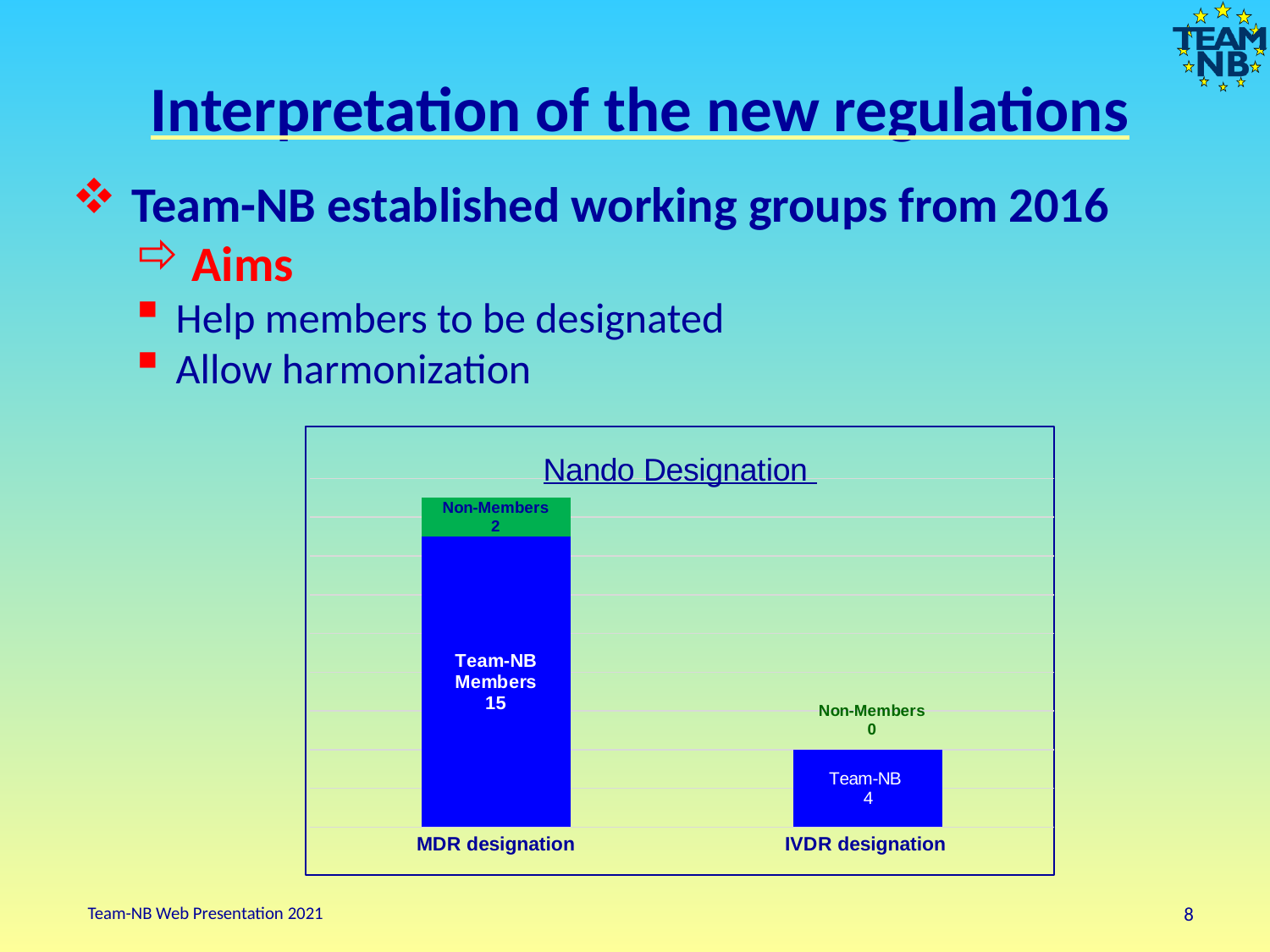
What type of chart is shown on the slide? stacked bar chart Which category has the lowest total? IVDR designation What is the title of the chart? Nando Designation How many categories are shown on the x axis? 2 How many Team-NB members are shown for IVDR designation? 4 How many Non-Members are shown for IVDR designation? 0 Which category has the higher total, MDR designation or IVDR designation? MDR designation How many Team-NB Members are shown for MDR designation? 15 What is the difference between Team-NB Members for MDR designation and Team-NB for IVDR designation? 11 What is the total of the IVDR designation bar? 4 How many Non-Members are shown for MDR designation? 2 What is the total of the MDR designation bar? 17